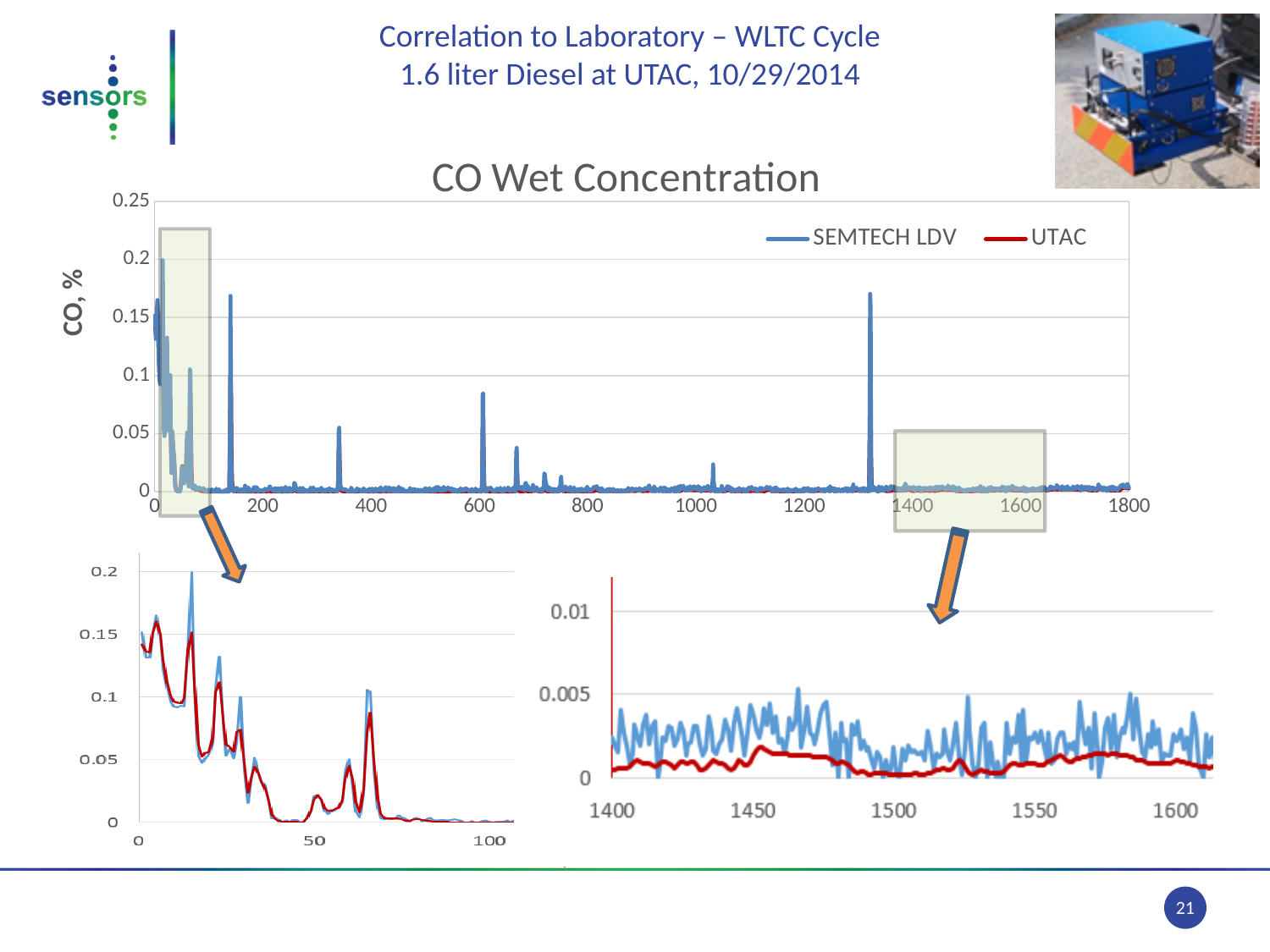
What are the two series named in the legend of the 'CO Wet Concentration' chart? SEMTECH LDV and UTAC In the 'CO Wet Concentration' chart, is the SEMTECH LDV spike near x = 1030 greater or less than 0.05? less How many series does the legend of the 'CO Wet Concentration' chart list? 2 In the bottom-right zoomed chart (x from 1400 to 1600), which series generally shows higher values, SEMTECH LDV or UTAC? SEMTECH LDV In the 'CO Wet Concentration' chart, is the SEMTECH LDV spike near x = 1320 greater or less than 0.15? greater In the 'CO Wet Concentration' chart, is the SEMTECH LDV spike near x = 600 greater or less than 0.05? greater What kind of chart is the main 'CO Wet Concentration' chart? line chart What is the y-axis title of the 'CO Wet Concentration' chart? CO, % In the bottom-left zoomed chart (x from 0 to 100), do the values generally rise or fall as x increases from 0 to 100? fall